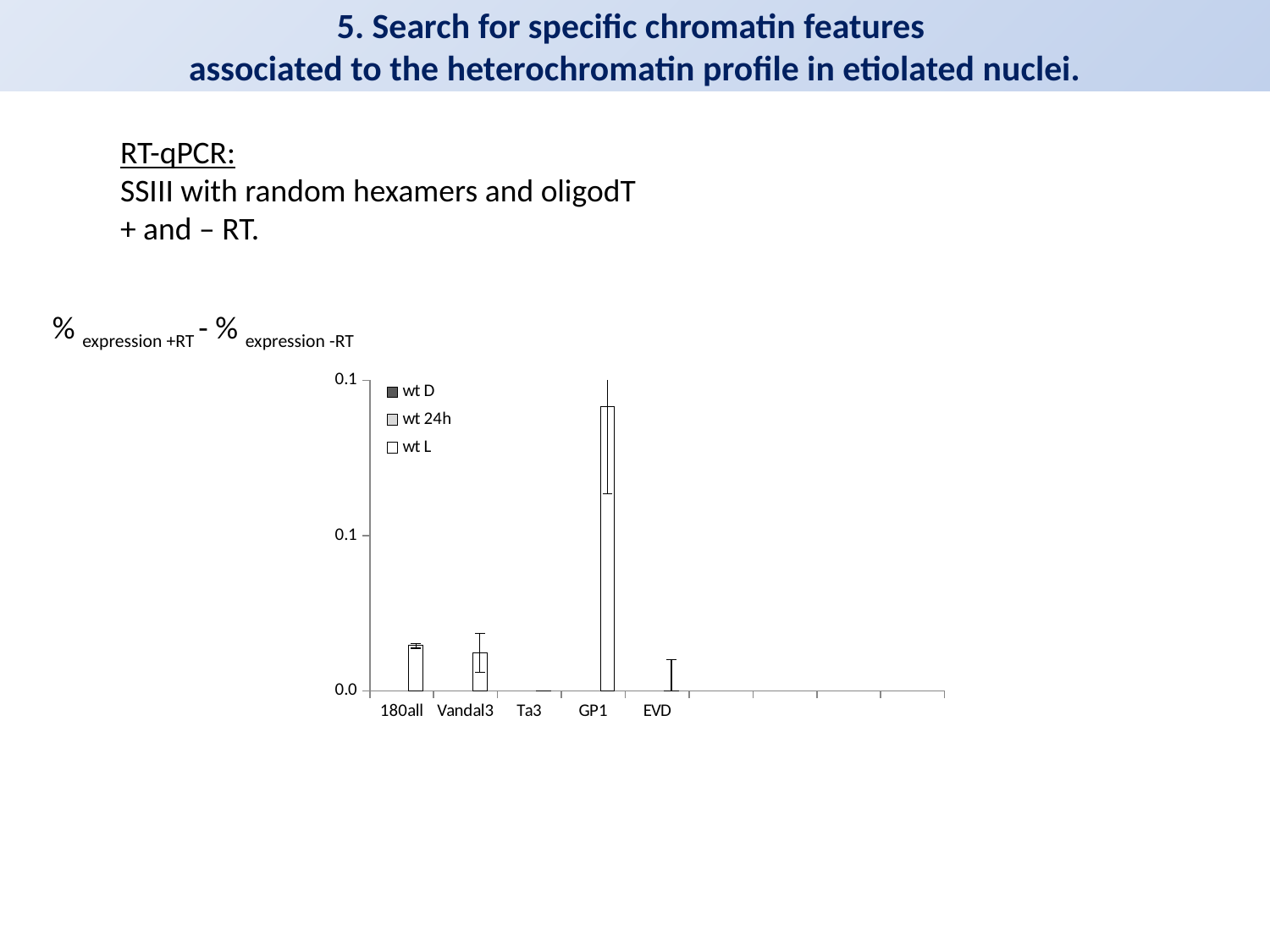
How many labeled categories are shown on the x axis of the chart? 5 Is the bar for Vandal3 greater or less than 0.1? less How many series does the chart legend list? 3 Which is larger, the bar for Vandal3 or the bar for Ta3? Vandal3 What is the lowest value shown on the y axis of the chart? 0.0 What is the label of the first category on the x axis of the chart? 180all What kind of chart is shown on the slide? bar chart Which is larger, the bar for GP1 or the bar for 180all? GP1 Which series are listed in the chart legend? wt D, wt 24h, wt L Which category has the highest bar in the chart? GP1 Is the bar for 180all greater or less than 0.1? less